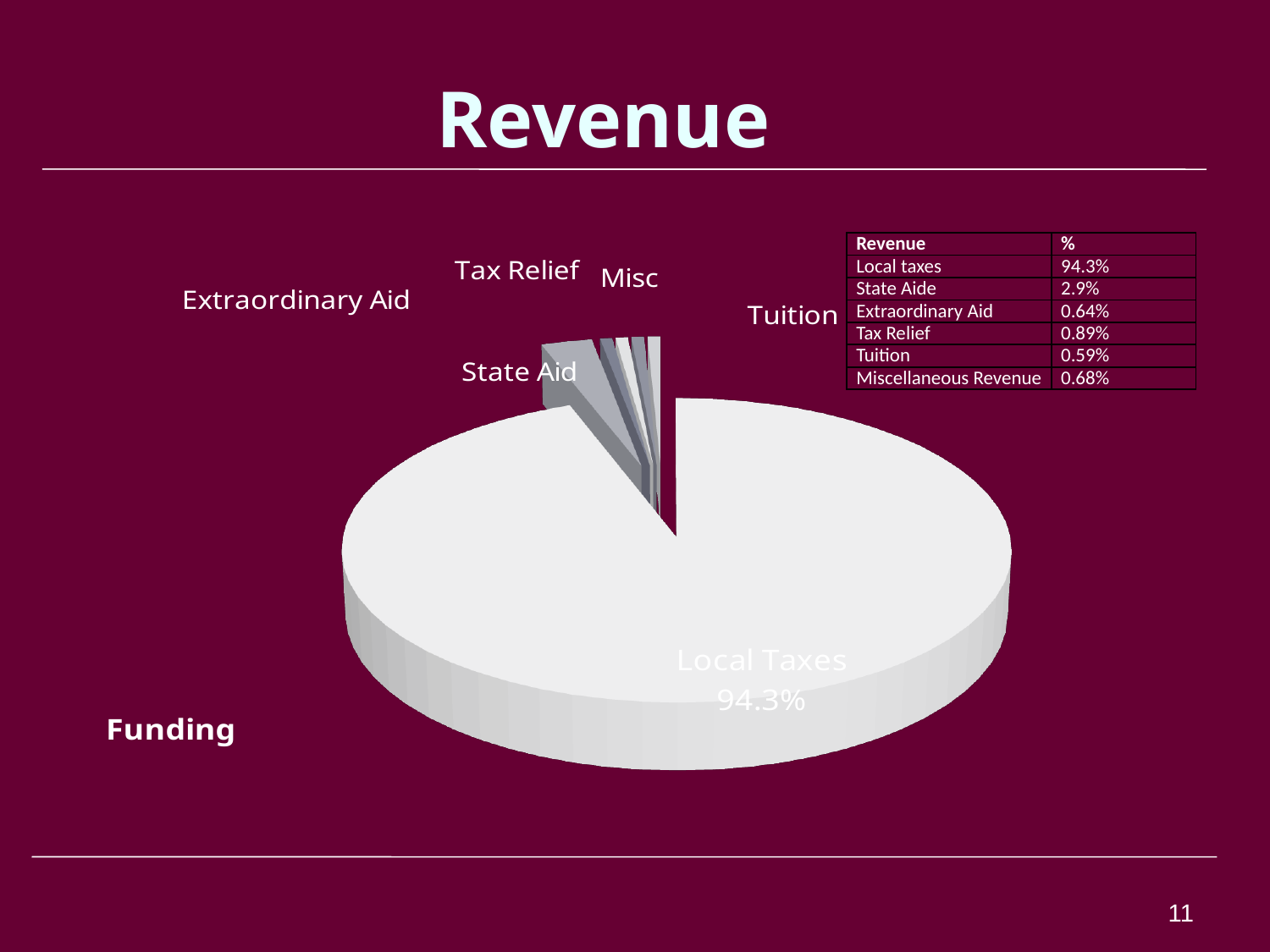
What is the title of the slide containing the chart? Revenue What percentage is listed for Tuition? 0.59% What percentage is listed for Tax Relief? 0.89% Which category has the smallest percentage according to the table? Tuition Which category has the largest slice of the pie chart? Local Taxes What percentage is listed for State Aide in the table? 2.9% What share of revenue comes from Local Taxes? 94.3% How many slices does the pie chart have? 6 Which is larger, Tax Relief or Extraordinary Aid? Tax Relief What is the difference between the Local taxes percentage and the State Aide percentage? 91.4% What kind of chart is shown on the slide? pie chart What percentage is listed for Miscellaneous Revenue? 0.68%